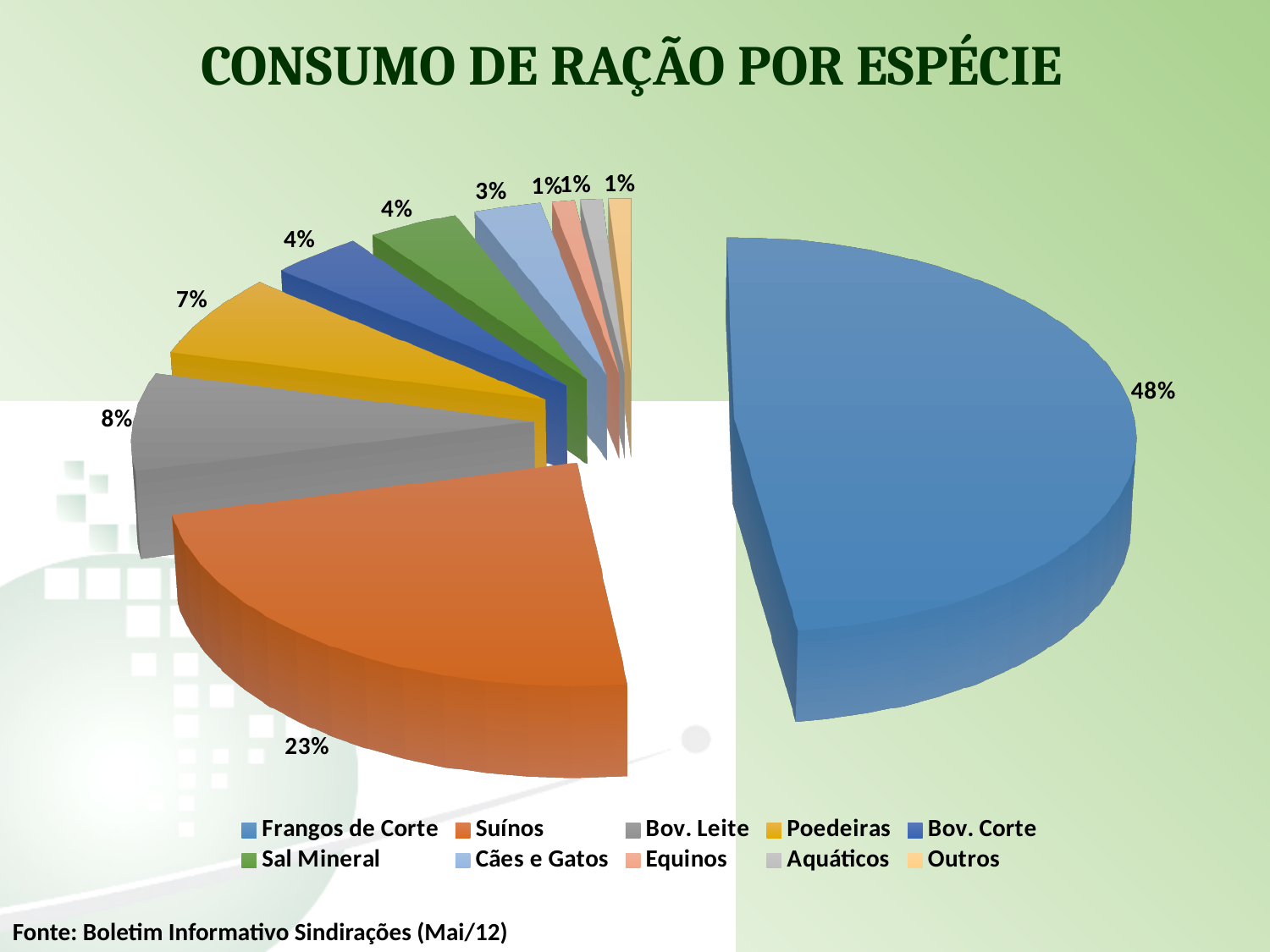
What is the value shown for Suínos? 23% What type of chart is shown on the slide? Pie chart What is the value shown for Bov. Leite? 8% What is the value shown for Poedeiras? 7% Which category has the largest share of the pie? Frangos de Corte How many categories does the legend list? 10 Which is larger, the share for Bov. Leite or the share for Poedeiras? Bov. Leite What is the difference between the shares of Frangos de Corte and Suínos? 25% What is the title of the chart? CONSUMO DE RAÇÃO POR ESPÉCIE What share of the pie does Frangos de Corte represent? 48% What colour is the slice for Suínos? Orange What is the value shown for Cães e Gatos? 3%